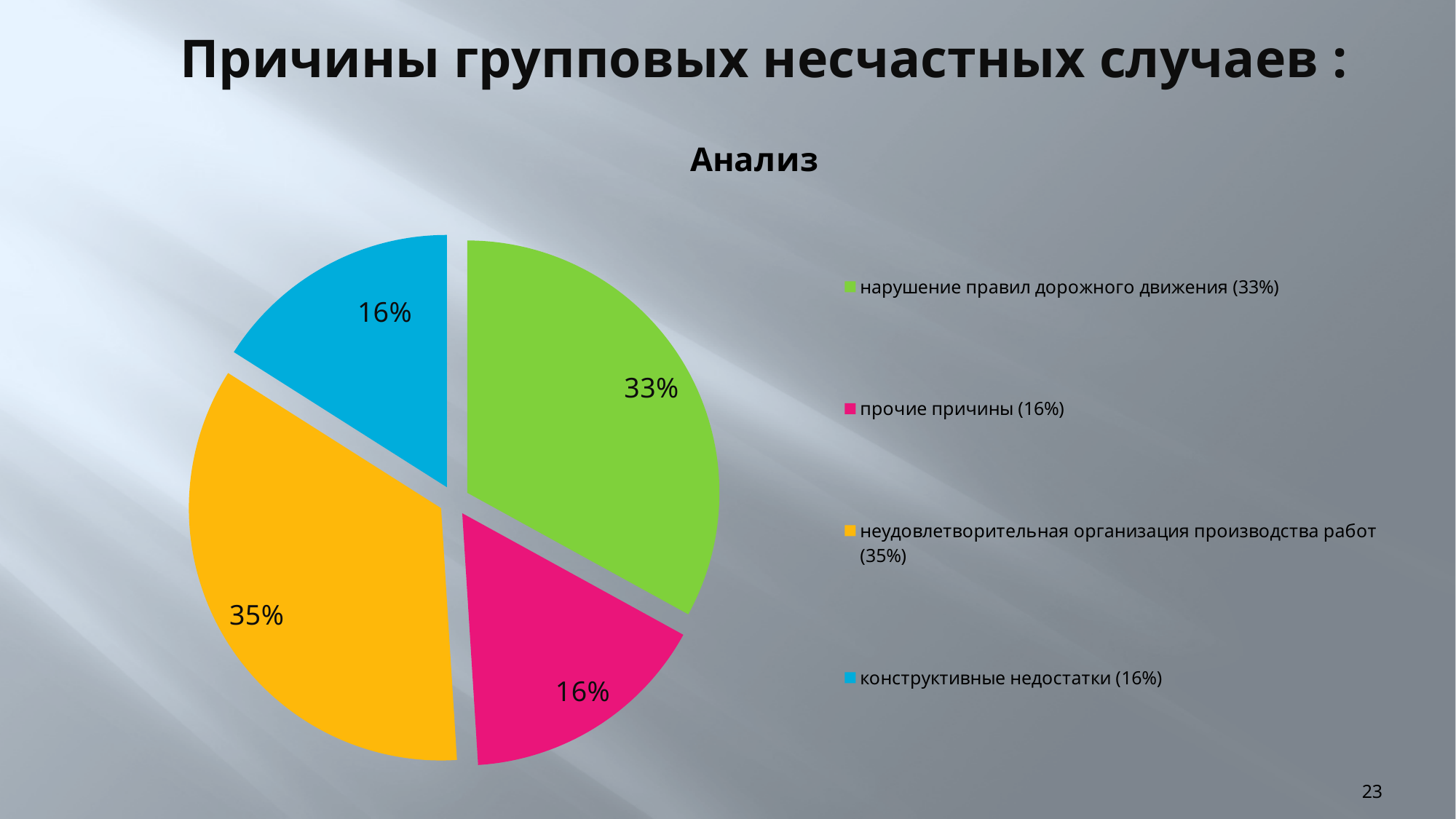
What kind of chart is shown on the slide? pie chart What is the difference in percentage points between 'нарушение правил дорожного движения' and 'конструктивные недостатки'? 17 What share of the pie is 'прочие причины'? 16% What share of the pie is 'неудовлетворительная организация производства работ'? 35% Which category has the largest share of the pie? неудовлетворительная организация производства работ What share of the pie is 'нарушение правил дорожного движения'? 33% What is the chart's title? Анализ How many slices does the pie chart have? 4 What colour is the slice for 'конструктивные недостатки'? blue What is the difference in percentage points between 'неудовлетворительная организация производства работ' and 'прочие причины'? 19 Which is larger: the share for 'нарушение правил дорожного движения' or for 'прочие причины'? нарушение правил дорожного движения